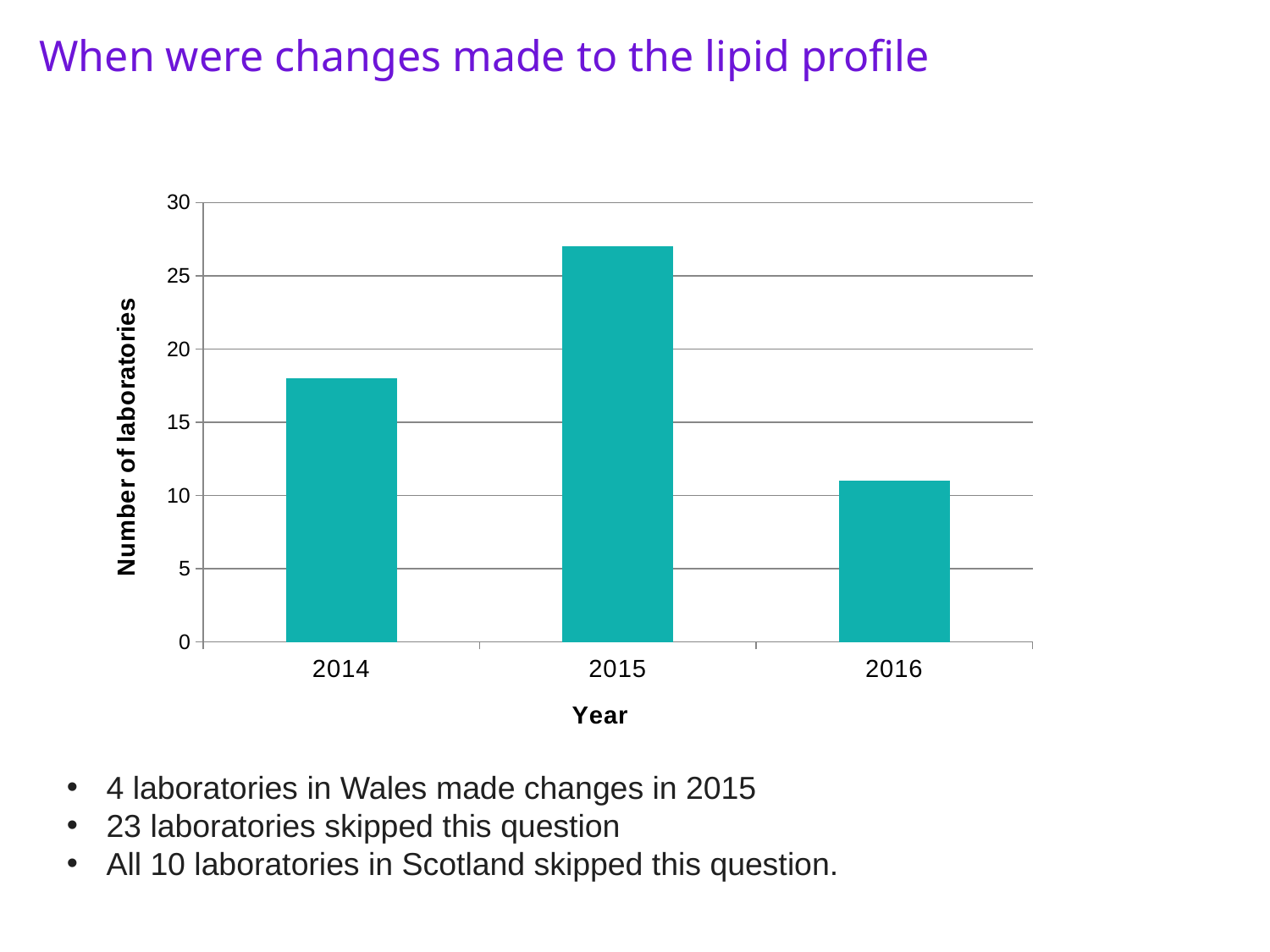
Which year has the highest number of laboratories? 2015 What kind of chart is shown on the slide? bar chart Which year has more laboratories, 2014 or 2016? 2014 Is the number of laboratories for 2014 greater or less than 15? greater How many years are shown on the x axis of the chart? 3 Which year has more laboratories, 2014 or 2015? 2015 Is the number of laboratories for 2016 greater or less than 15? less Is the number of laboratories for 2014 greater or less than 20? less Which year has the lowest number of laboratories? 2016 What is the label of the y axis of the chart? Number of laboratories What is the label of the x axis of the chart? Year